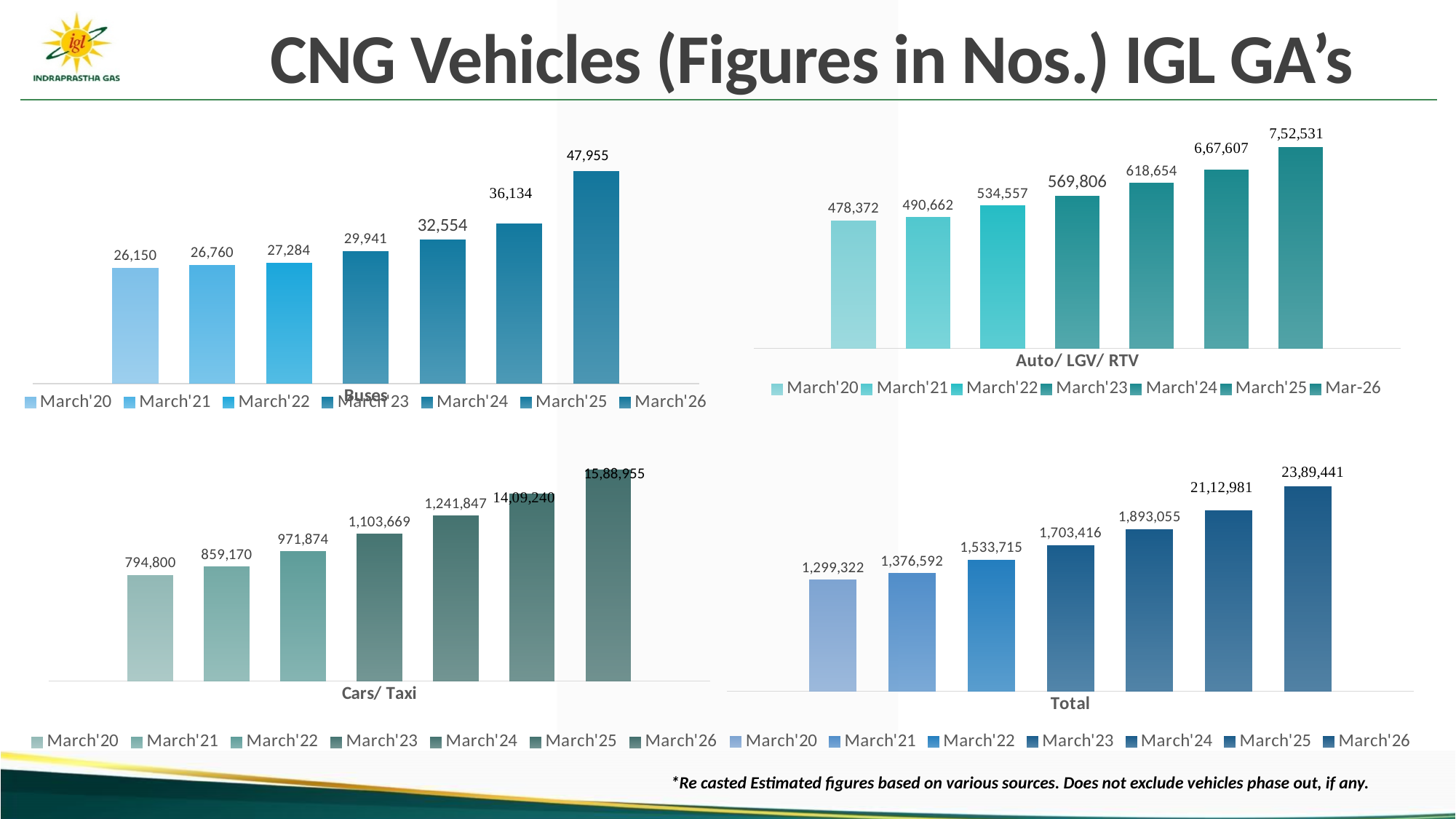
What type of chart is the Total chart? Bar chart In the Cars/ Taxi chart, what is the value for March'20? 794,800 How many bars are shown in the Auto/ LGV/ RTV chart? 7 In the Total chart, which year has the highest value? March'26 In the Buses chart, what is the difference between the March'26 and March'25 values? 11,821 In the Auto/ LGV/ RTV chart, what is the value for March'23? 569,806 In the Buses chart, what is the value for March'26? 47,955 In the Buses chart, which year has the lowest value? March'20 In the Total chart, what is the difference between the March'21 and March'20 values? 77,270 In the Cars/ Taxi chart, which is larger, the value for March'22 or March'23? March'23 How many entries does the legend of the Cars/ Taxi chart list? 7 In the Total chart, what is the value for March'24? 1,893,055